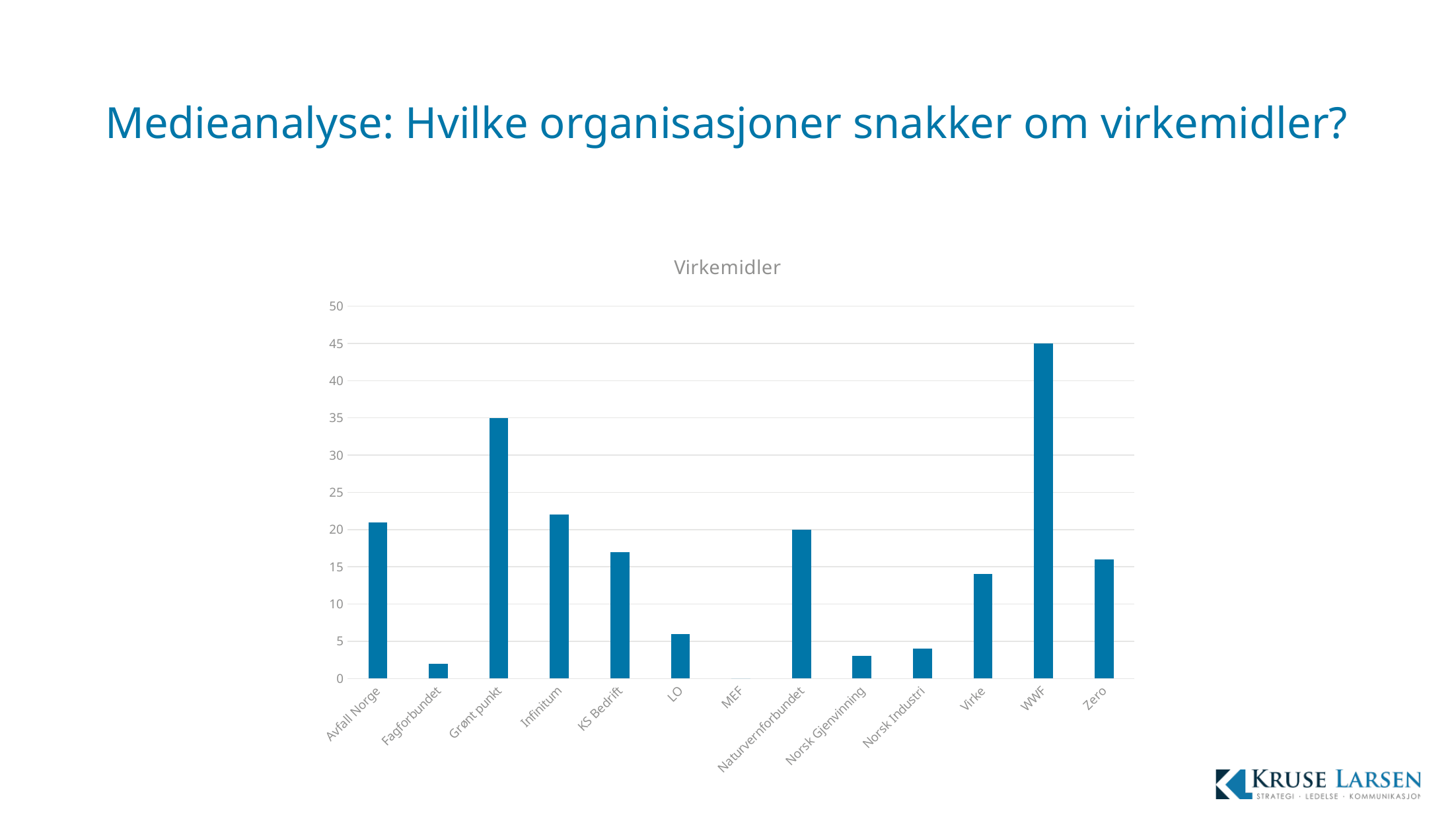
Is the value for Avfall Norge greater or less than 25? less What type of chart is shown on the slide? bar chart What is the title of the chart? Virkemidler Which organisation has the highest value in the chart? WWF Is the value for KS Bedrift greater or less than 20? less What is the difference between the values for WWF and Grønt punkt? 10 What is the value for Naturvernforbundet? 20 How many organisations are shown on the x axis of the chart? 13 Which organisation has the lowest value in the chart? MEF What is the value for Grønt punkt? 35 What is the value for WWF? 45 Which has the larger value, Grønt punkt or Infinitum? Grønt punkt